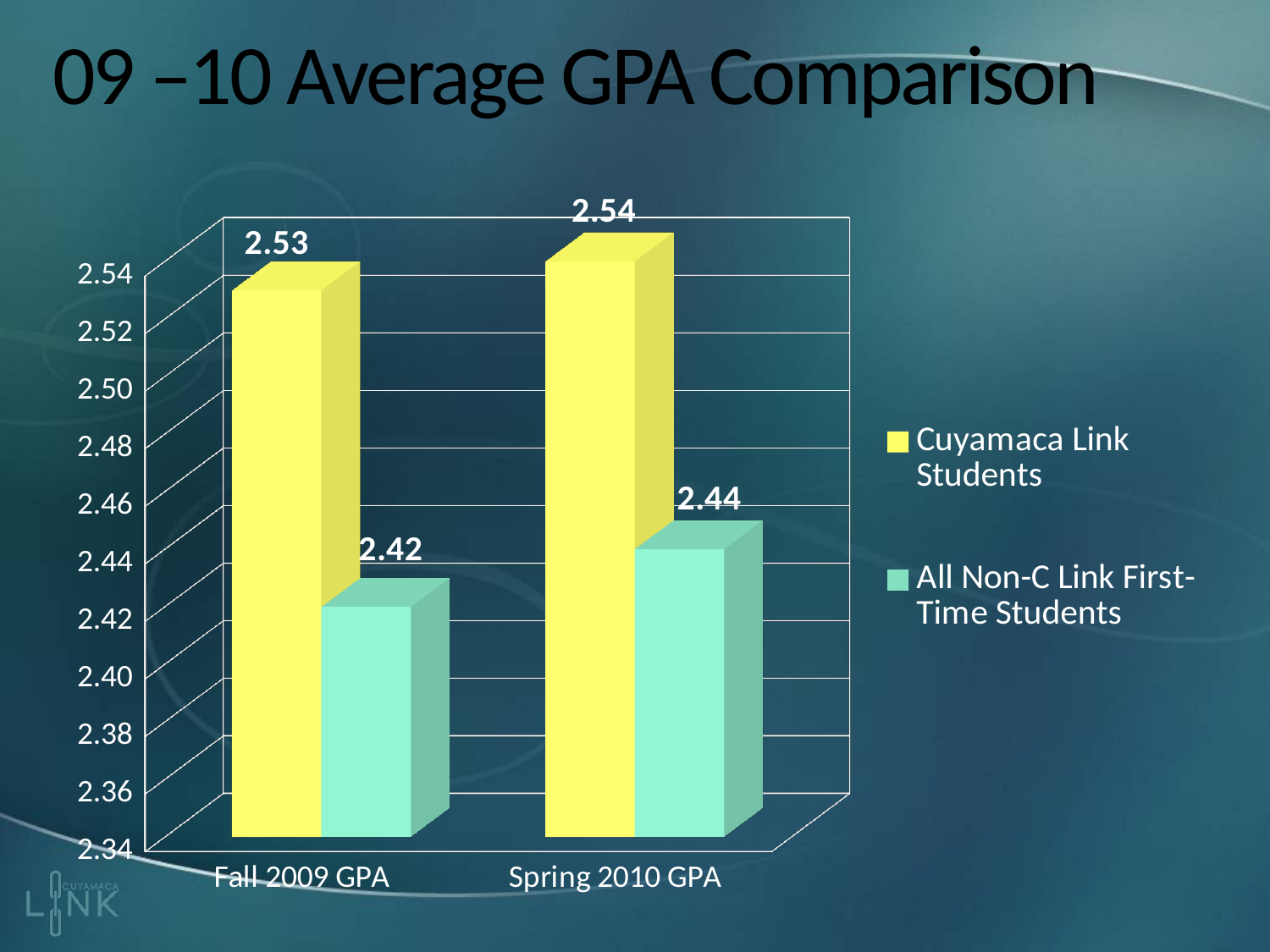
What is the Spring 2010 GPA for All Non-C Link First-Time Students? 2.44 Which group has the higher Fall 2009 GPA? Cuyamaca Link Students What is the difference between the Cuyamaca Link Students' and the All Non-C Link First-Time Students' Spring 2010 GPA? 0.10 What is the Fall 2009 GPA for Cuyamaca Link Students? 2.53 What is the Fall 2009 GPA for All Non-C Link First-Time Students? 2.42 What kind of chart is shown on the slide? Bar chart How many series does the legend list? 2 How many categories are shown on the x axis? 2 By how much did the GPA of All Non-C Link First-Time Students change from Fall 2009 to Spring 2010? 0.02 Which bar shows the lowest GPA on the chart? All Non-C Link First-Time Students, Fall 2009 GPA What is the Spring 2010 GPA for Cuyamaca Link Students? 2.54 What is the title of the slide? 09 – 10 Average GPA Comparison